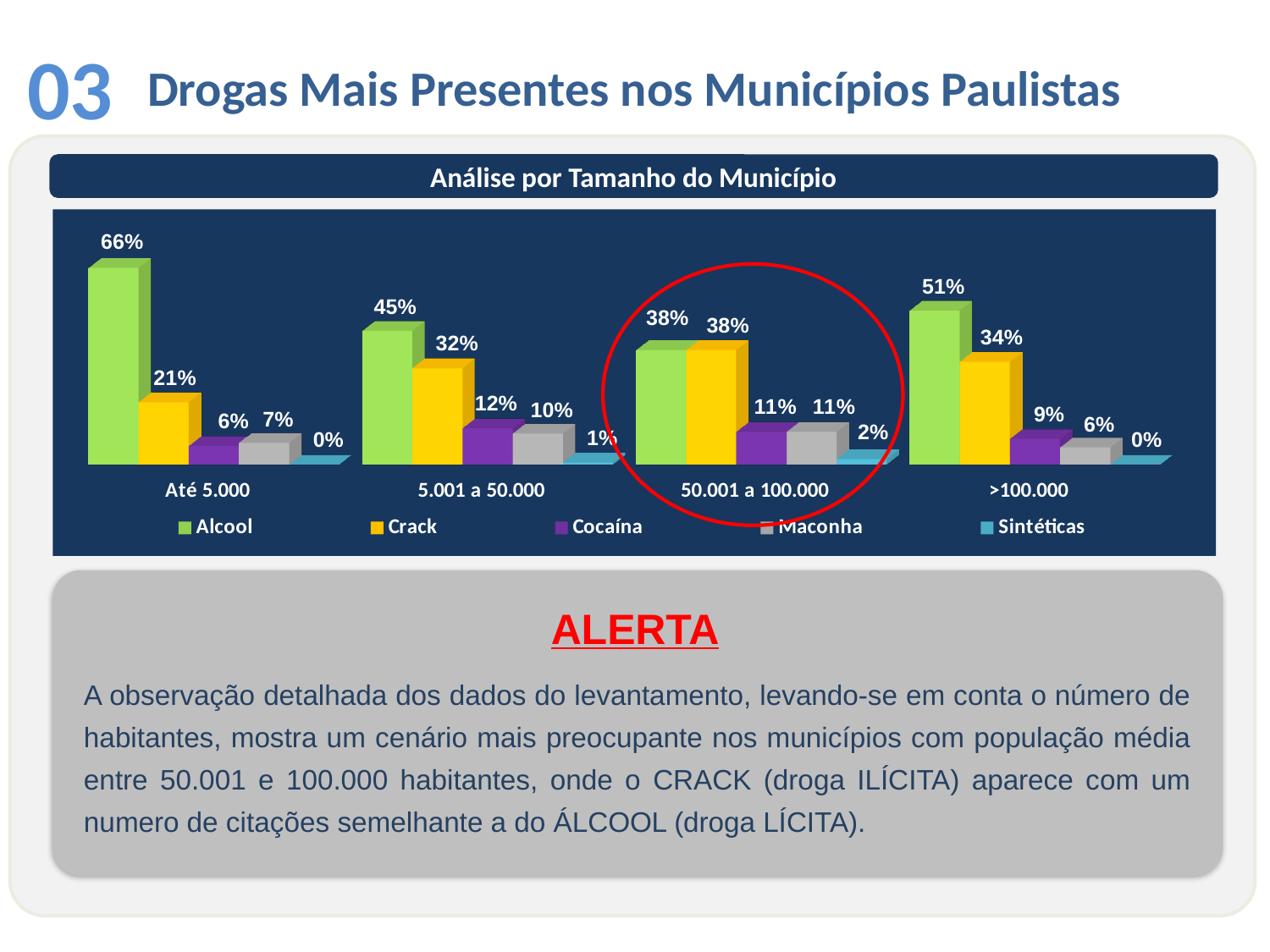
Which is larger in the '>100.000' category: Alcool or Crack? Alcool What is the difference between the Alcool and Crack values in the 'Até 5.000' category? 45% Which category has the lowest value for Crack? Até 5.000 What kind of chart is shown? Bar chart What is the value for Crack in the '50.001 a 100.000' category? 38% What is the title of the chart? Análise por Tamanho do Município What is the value for Maconha in the '>100.000' category? 6% How many categories are shown on the x axis? 4 What is the value for Cocaína in the '5.001 a 50.000' category? 12% What is the value for Alcool in the 'Até 5.000' category? 66% Which category has the highest value for Alcool? Até 5.000 How many series does the legend list? 5